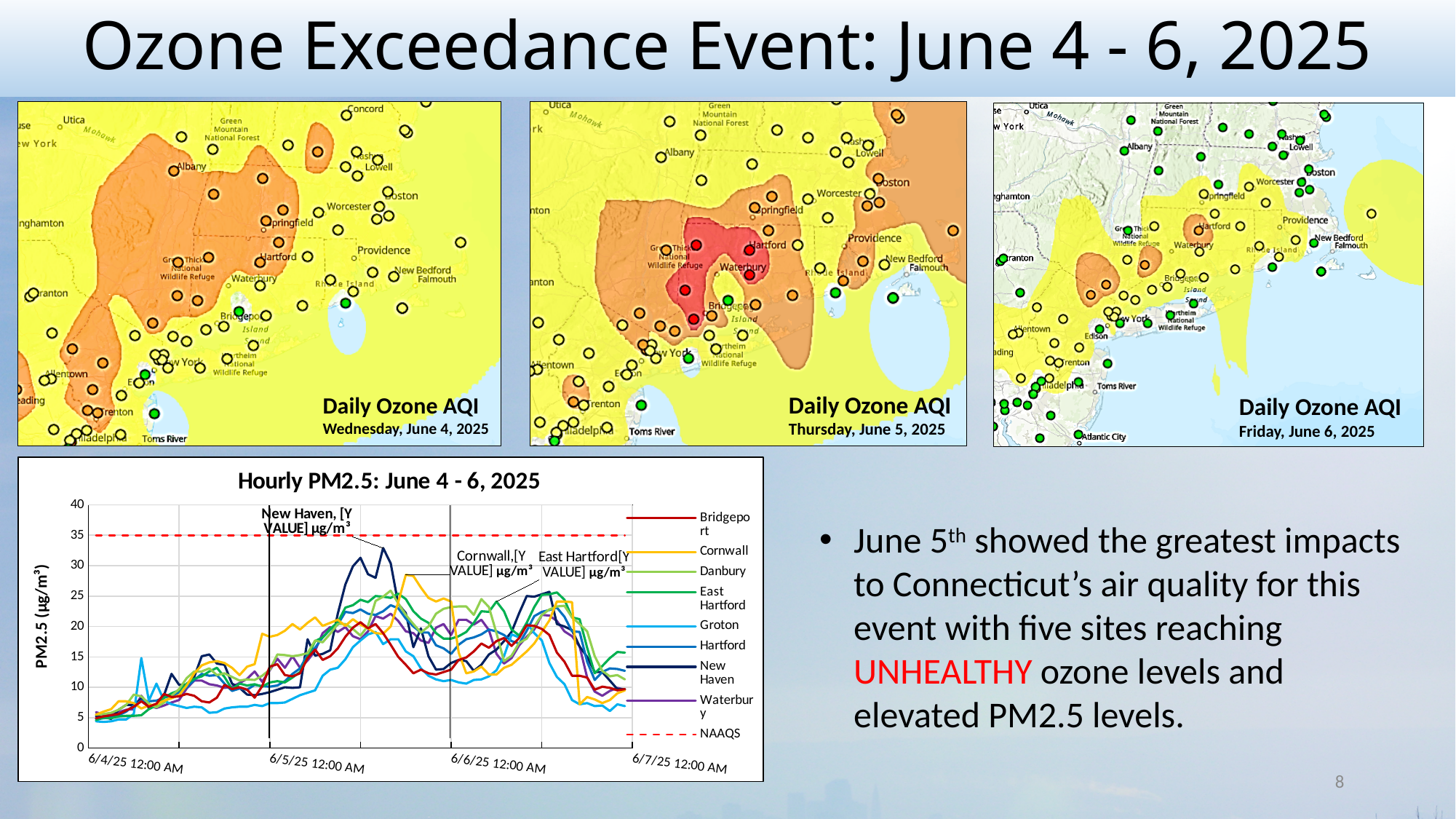
At what value on the y-axis is the dashed NAAQS line drawn in the Hourly PM2.5 chart? 35 In the Hourly PM2.5 chart, do the values generally rise or fall between 6/4/25 12:00 AM and 6/5/25 12:00 AM? rise How many labeled date ticks are shown on the x-axis of the Hourly PM2.5 chart? 4 How many entries does the legend of the Hourly PM2.5 chart list? 9 In the Hourly PM2.5 chart, does any site's line exceed the NAAQS line? No In the Hourly PM2.5 chart, which site reaches the highest peak value? New Haven In the Hourly PM2.5 chart, is the peak value for Cornwall greater or less than 35? less In the Hourly PM2.5 chart, is the peak value for New Haven greater or less than 30? greater What is the y-axis label of the Hourly PM2.5 chart? PM2.5 (µg/m³) What is the title of the line chart on the slide? Hourly PM2.5: June 4 - 6, 2025 In the Hourly PM2.5 chart, which site has the higher peak, New Haven or Groton? New Haven What kind of chart is the "Hourly PM2.5: June 4 - 6, 2025" chart? line chart